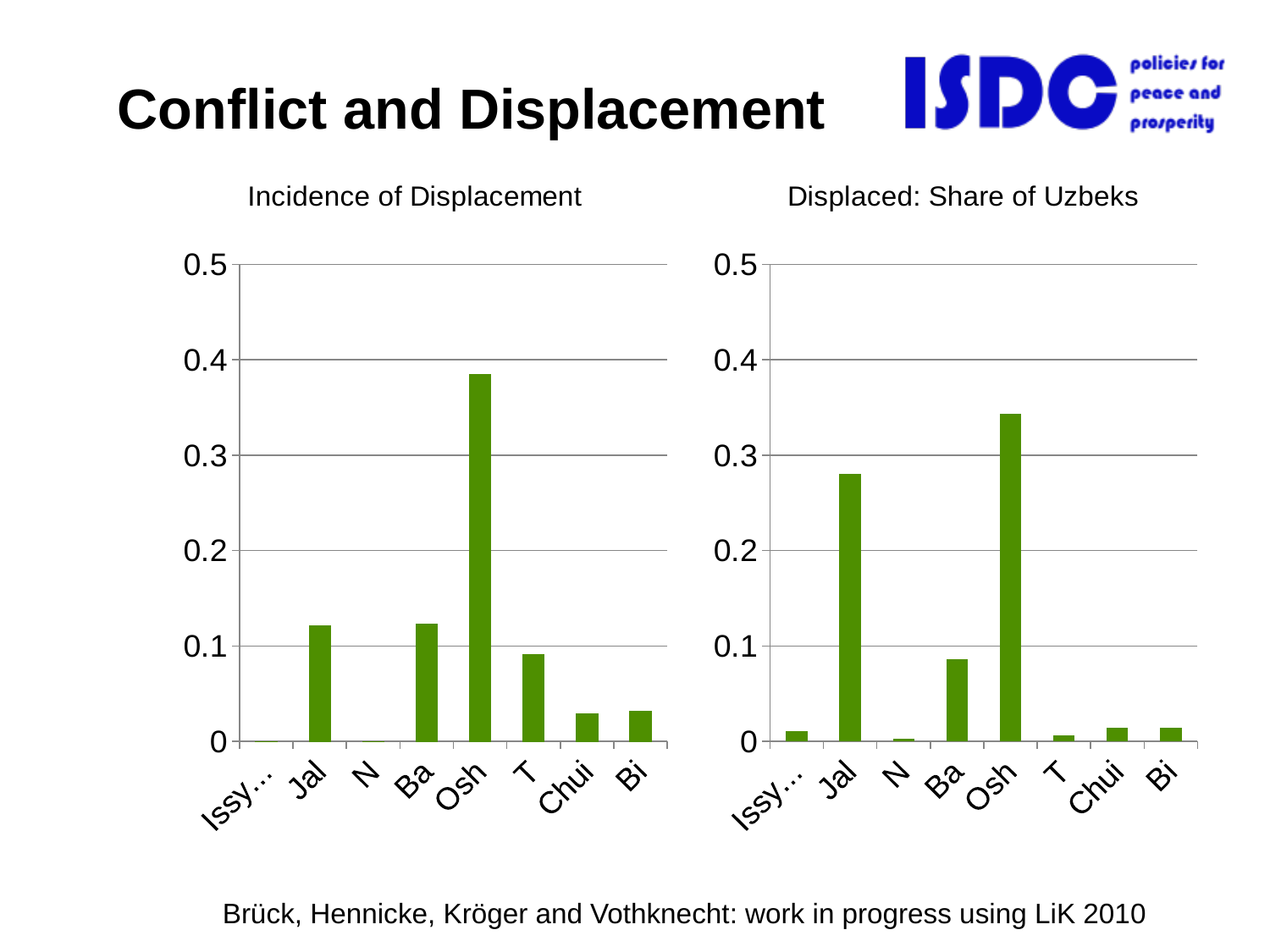
In the 'Incidence of Displacement' chart, is the value for Jal greater or less than 0.1? greater In the 'Displaced: Share of Uzbeks' chart, which is larger, the value for Jal or the value for Ba? Jal What is the title of the chart on the left side of the slide? Incidence of Displacement In the 'Displaced: Share of Uzbeks' chart, is the value for Jal greater or less than 0.3? less In the 'Incidence of Displacement' chart, is the value for Osh greater or less than 0.3? greater In the 'Displaced: Share of Uzbeks' chart, which category has the highest value? Osh How many categories are shown on the x axis of the 'Incidence of Displacement' chart? 8 What kind of chart is the 'Displaced: Share of Uzbeks' chart? bar chart In the 'Incidence of Displacement' chart, which category has the highest value? Osh In the 'Incidence of Displacement' chart, which is larger, the value for Osh or the value for T? Osh